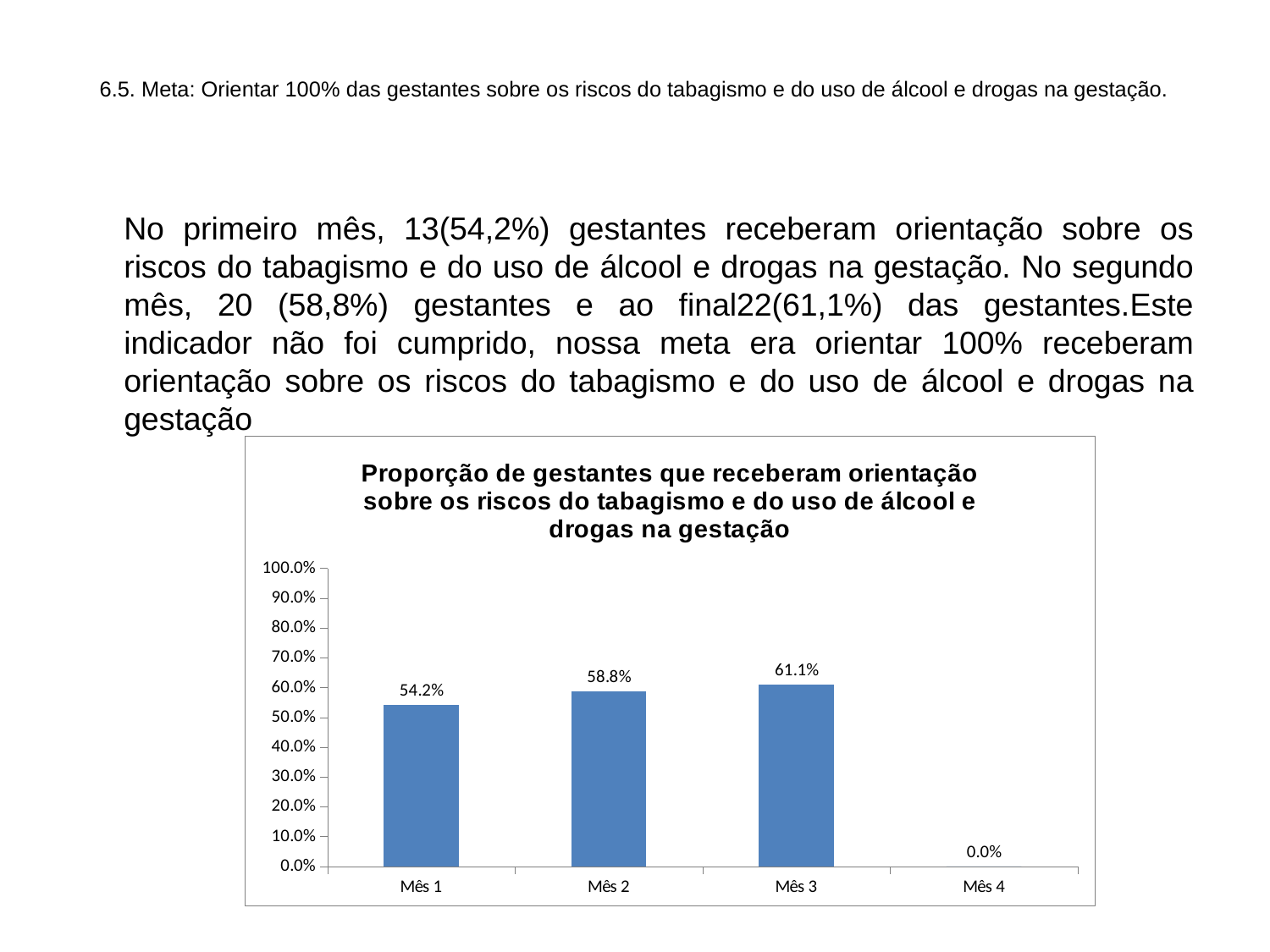
What is the value for Mês 3? 61.1% What is the difference between the values for Mês 3 and Mês 1? 6.9% Which month has the highest value? Mês 3 Is the value for Mês 3 greater or less than 70.0%? less Which is larger, the value for Mês 2 or the value for Mês 1? Mês 2 What is the value for Mês 1? 54.2% Which month has the lowest value? Mês 4 What is the value for Mês 4? 0.0% Do the values rise or fall from Mês 1 to Mês 3? rise What kind of chart is shown on the slide? bar chart What is the value for Mês 2? 58.8% How many categories are shown on the x axis? 4